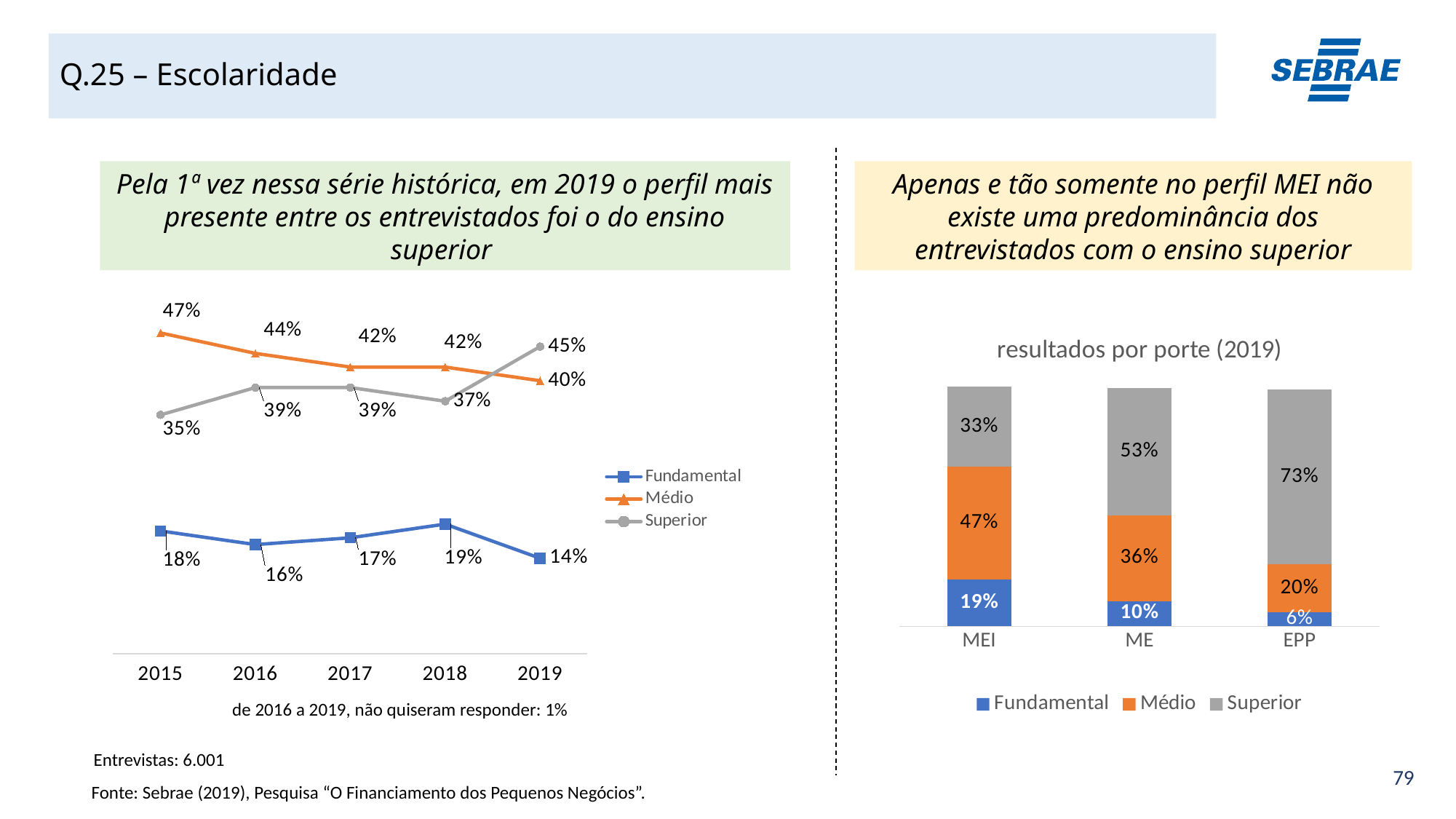
In the line chart on the left, what was the value for Superior in 2019? 45% In the 'resultados por porte (2019)' chart, which category has the highest Fundamental share? MEI What kind of chart is the 'resultados por porte (2019)' chart on the right? stacked bar chart In the 'resultados por porte (2019)' chart, what is the Superior share for EPP? 73% In the line chart on the left, by how many percentage points did Médio fall from 2015 to 2019? 7 percentage points In the 'resultados por porte (2019)' chart, what is the difference between the Superior shares of EPP and MEI? 40 percentage points In the line chart on the left, how many years are shown on the x axis? 5 In the line chart on the left, in which year was Fundamental lowest? 2019 In the line chart on the left, what was the value for Médio in 2015? 47% In the 'resultados por porte (2019)' chart, which is larger for ME: Médio or Superior? Superior In the line chart on the left, does the Médio series rise or fall from 2015 to 2019? fall In the line chart on the left, how many series does the legend list? 3